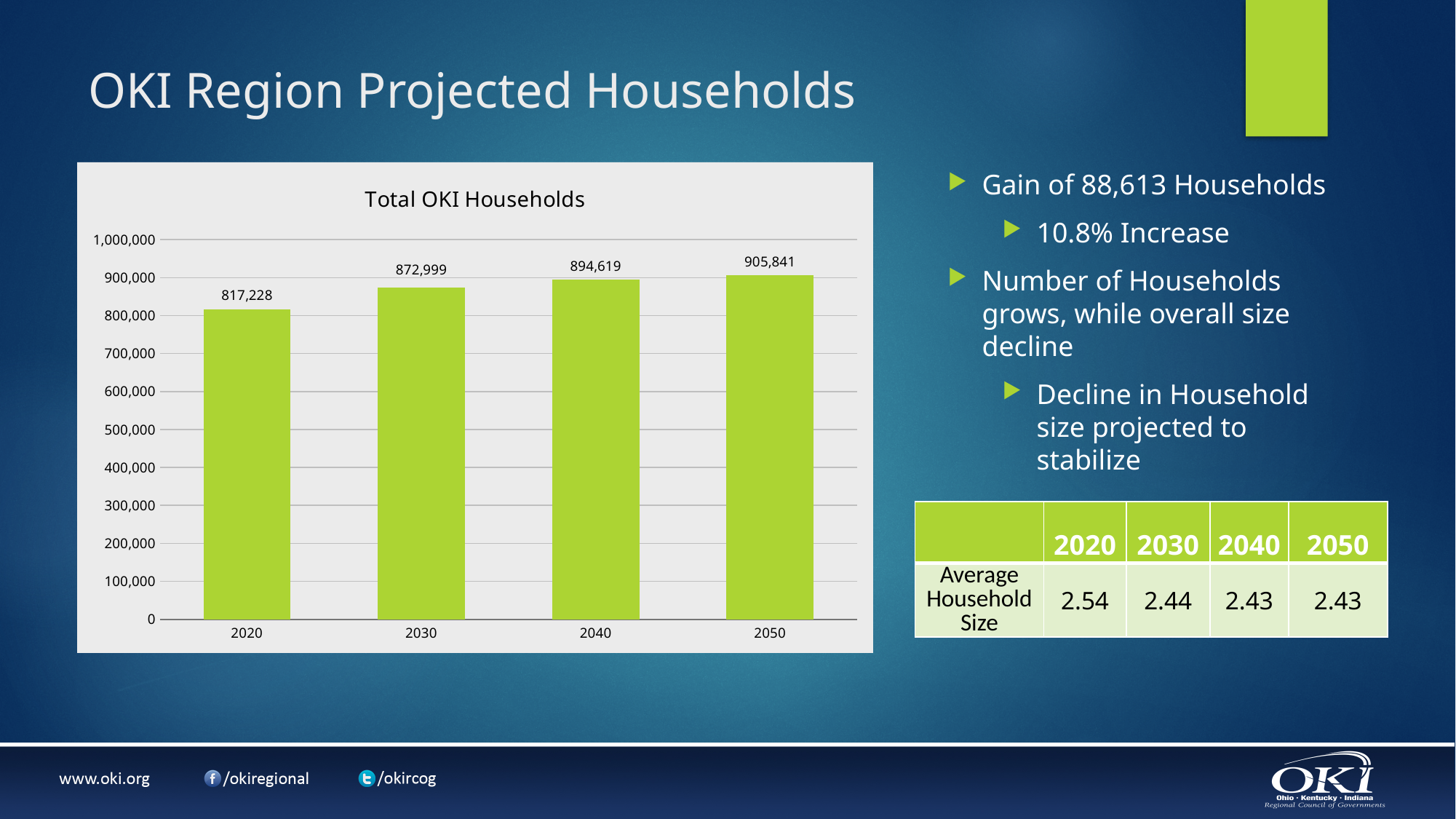
What is the value for 2020 in the Total OKI Households chart? 817,228 Which year has the lowest value in the Total OKI Households chart? 2020 What is the difference between the 2050 and 2020 values in the Total OKI Households chart? 88,613 Which year has the highest value in the Total OKI Households chart? 2050 Do the values in the Total OKI Households chart rise or fall from 2020 to 2050? Rise How many years are shown on the x axis of the Total OKI Households chart? 4 What is the value for 2040 in the Total OKI Households chart? 894,619 What is the value for 2030 in the Total OKI Households chart? 872,999 What is the value for 2050 in the Total OKI Households chart? 905,841 Which is larger in the Total OKI Households chart, the value for 2030 or the value for 2040? 2040 What kind of chart is the Total OKI Households chart? Bar chart What is the difference between the 2030 and 2020 values in the Total OKI Households chart? 55,771